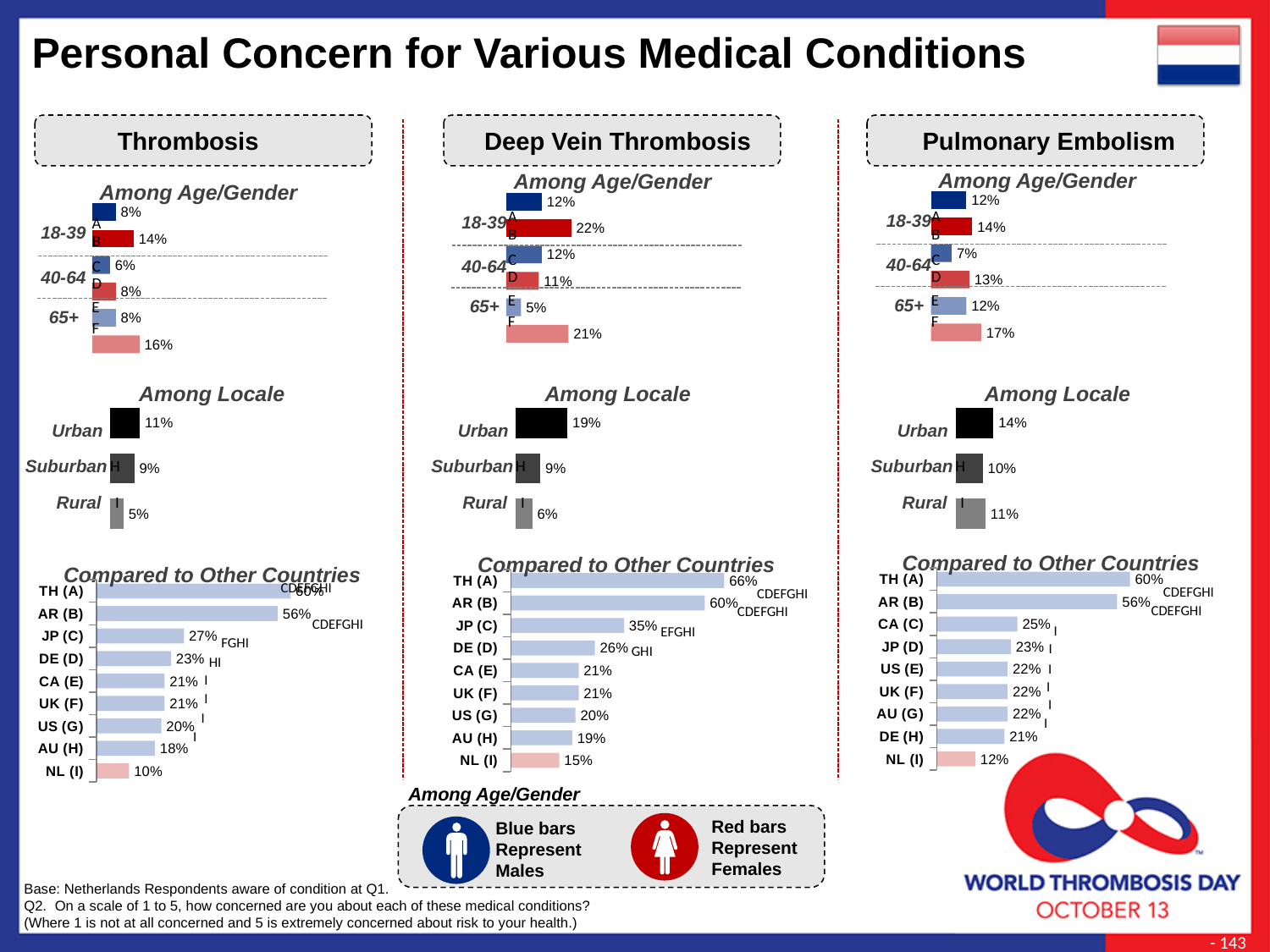
According to the legend at the bottom of the slide, what do the red bars in the 'Among Age/Gender' charts represent? Females In the Pulmonary Embolism 'Among Age/Gender' chart, what is the value for the female (red) bar in the 65+ group (F)? 17% How many countries are listed in the Pulmonary Embolism 'Compared to Other Countries' chart? 9 In the Thrombosis 'Compared to Other Countries' chart, which country has the lowest value? NL (I) In the Thrombosis 'Among Age/Gender' chart, what is the difference between the female (B) and male (A) values in the 18-39 group? 6% In the Thrombosis 'Among Locale' chart, what is the value for Rural? 5% In the Deep Vein Thrombosis 'Among Locale' chart, what is the difference between the Urban and Rural values? 13% In the Deep Vein Thrombosis 'Compared to Other Countries' chart, which country has the highest value? TH (A) What type of chart is the Thrombosis 'Compared to Other Countries' chart? Bar chart In the Deep Vein Thrombosis 'Compared to Other Countries' chart, what is the value for JP (C)? 35% In the Deep Vein Thrombosis 'Among Age/Gender' chart, what is the value for the male (blue) bar in the 65+ group (E)? 5% In the Pulmonary Embolism 'Among Locale' chart, which is larger, the Suburban value or the Rural value? Rural